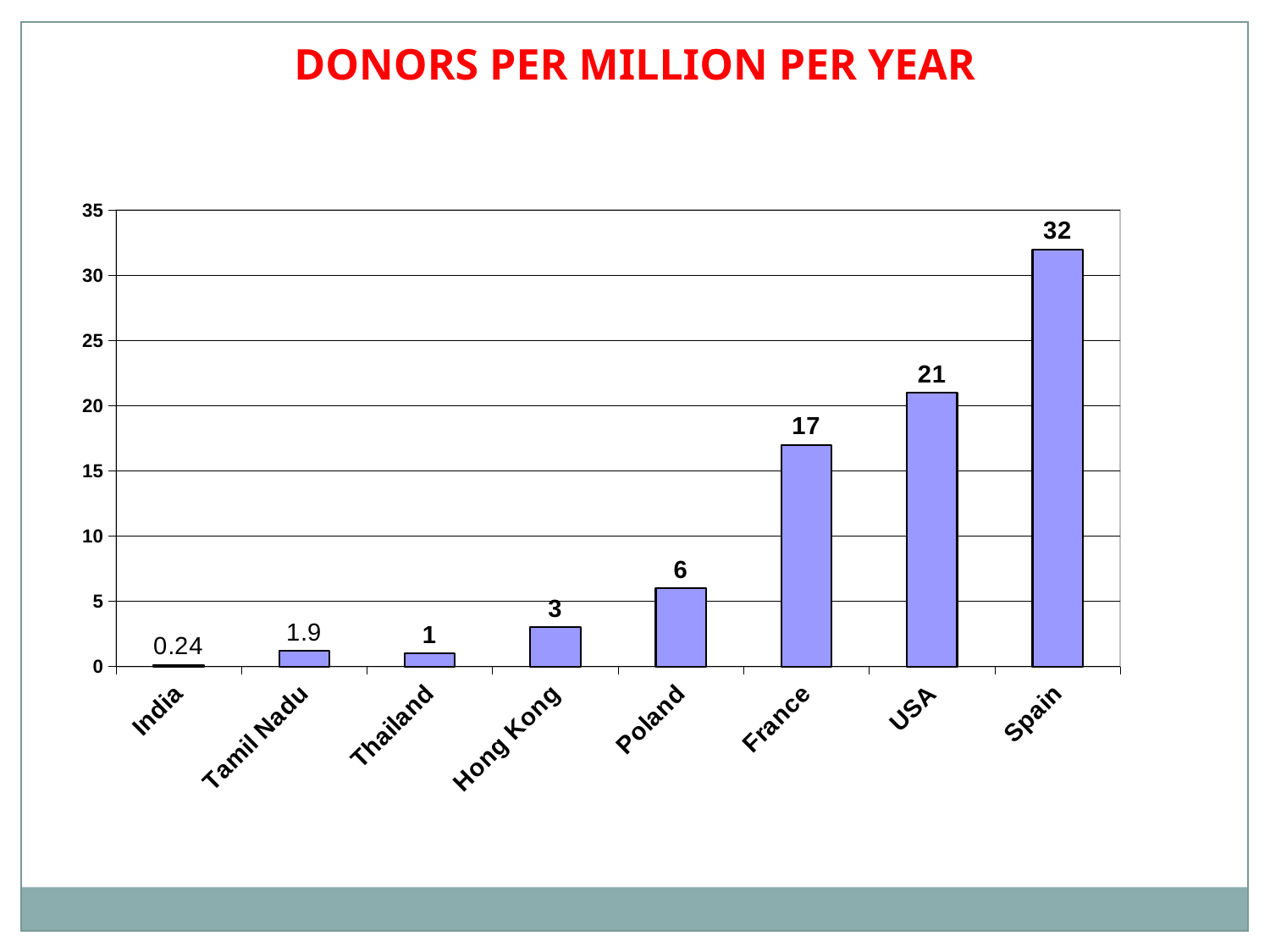
Which is larger, the value for Poland or the value for Hong Kong? Poland What is the value for Spain? 32 What is the value for Tamil Nadu? 1.9 What is the value for France? 17 What is the title of the chart? DONORS PER MILLION PER YEAR What is the difference between the values for Spain and USA? 11 How many categories are shown on the x axis? 8 Is the value for USA greater or less than 20? greater What is the value for India? 0.24 Which category has the highest value? Spain Which category has the lowest value? India What kind of chart is shown on the slide? bar chart